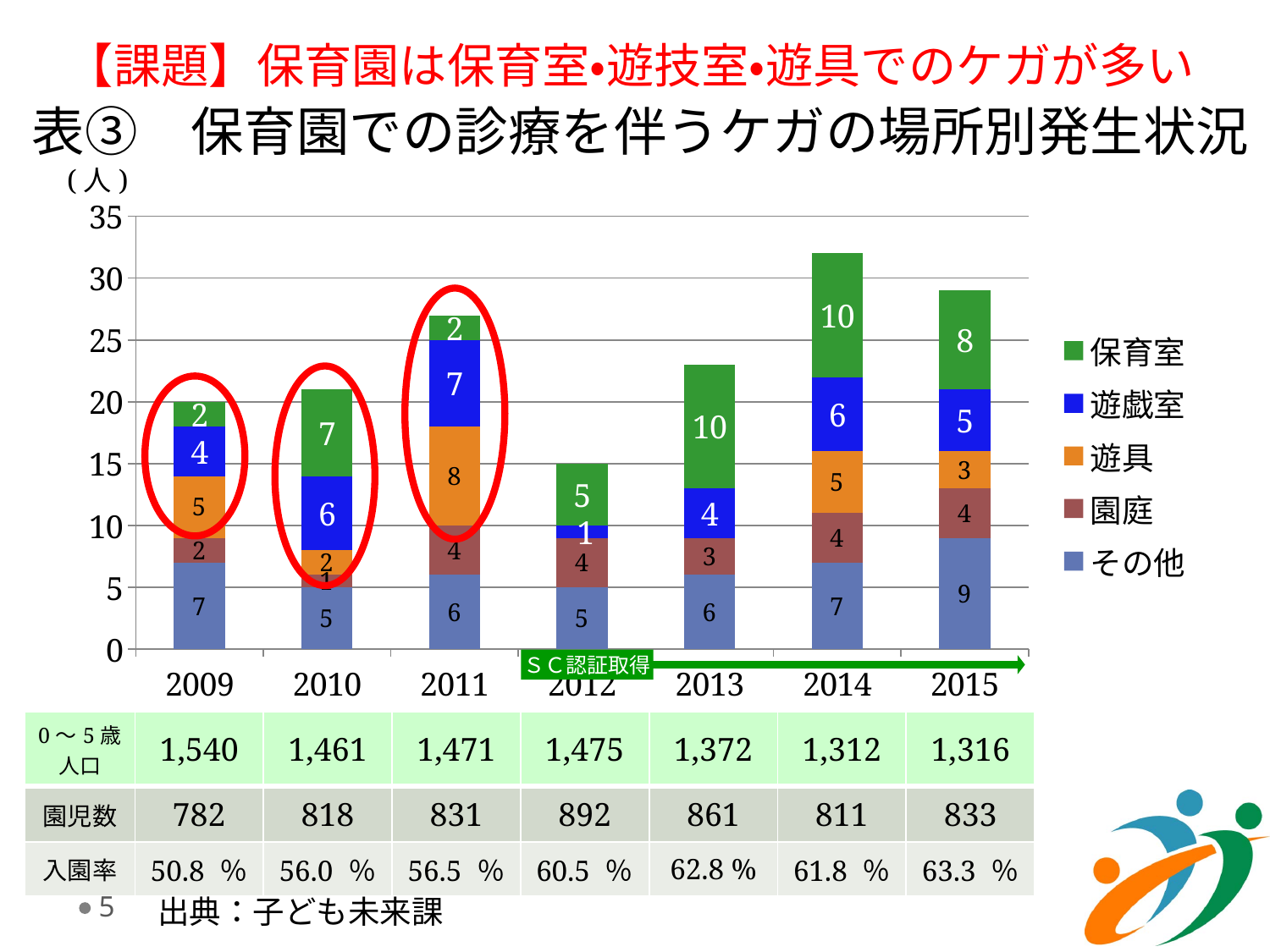
Which series is shown in green in the legend? 保育室 Which year has the shortest stacked bar overall? 2012 What is the value for 遊戯室 in 2010? 6 What is the value for 遊具 in 2011? 8 What type of chart is shown on the slide? Stacked bar chart Which year has the tallest stacked bar overall? 2014 How many years are shown along the x axis? 7 How many series does the legend list? 5 What is the value for その他 in 2015? 9 What is the total of the stacked bar for 2011? 27 Which is larger, the 遊具 value in 2011 or in 2014? 2011 What is the difference between the 保育室 value in 2014 and in 2009? 8